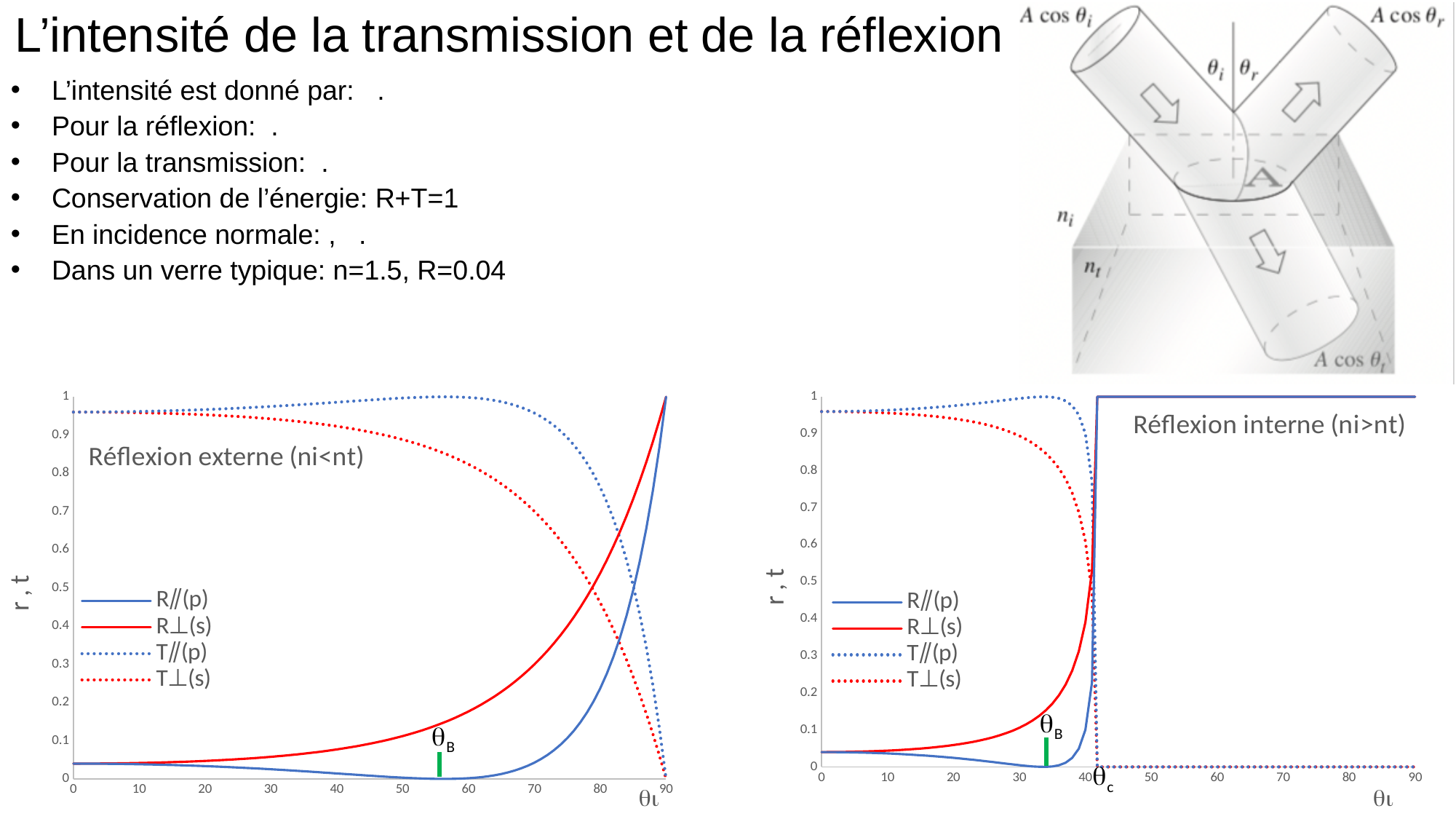
How many series does the legend of the left chart 'Réflexion externe (ni<nt)' list? 4 In the left chart 'Réflexion externe (ni<nt)', is the value of R∥(p) at 60 degrees greater or less than 0.1? less In the left chart 'Réflexion externe (ni<nt)', is the value of T∥(p) at 40 degrees greater or less than 0.9? greater In the right chart 'Réflexion interne (ni>nt)', is the value of T⊥(s) at 70 degrees greater or less than 0.1? less In the left chart 'Réflexion externe (ni<nt)', which is larger at 70 degrees, R⊥(s) or R∥(p)? R⊥(s) In the left chart 'Réflexion externe (ni<nt)', does the T⊥(s) series rise or fall as the angle increases from 0 to 90? fall What kind of chart is the left chart titled 'Réflexion externe (ni<nt)'? line chart How many series does the legend of the right chart 'Réflexion interne (ni>nt)' list? 4 What is the label on the y axis of the left chart 'Réflexion externe (ni<nt)'? r , t In the left chart 'Réflexion externe (ni<nt)', does the R⊥(s) series rise or fall as the angle increases from 0 to 90? rise In the right chart 'Réflexion interne (ni>nt)', which is larger at 30 degrees, T⊥(s) or R⊥(s)? T⊥(s)